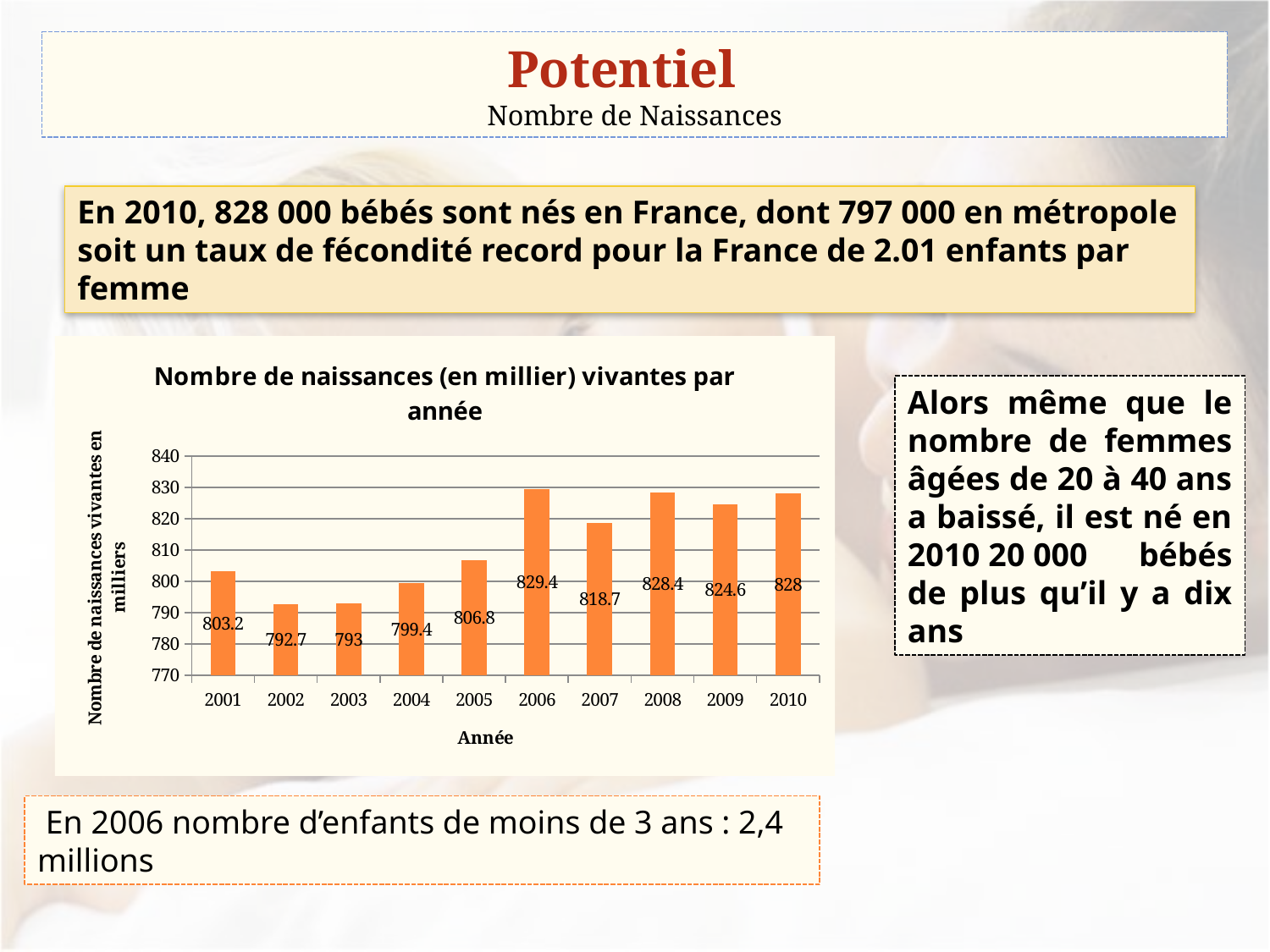
Overall, do the values rise or fall from 2001 to 2010? Rise How many years are shown on the x axis? 10 Which year has a larger value, 2009 or 2007? 2009 Which year has the lowest number of live births? 2002 What is the number of live births (in thousands) for 2010? 828 What is the title of the chart? Nombre de naissances (en millier) vivantes par année What is the value shown for 2007? 818.7 What is the difference between the values for 2010 and 2001? 24.8 What type of chart is shown on the slide? Bar chart Which year has the highest number of live births? 2006 What is the difference between the values for 2006 and 2005? 22.6 What is the number of live births (in thousands) for 2001? 803.2